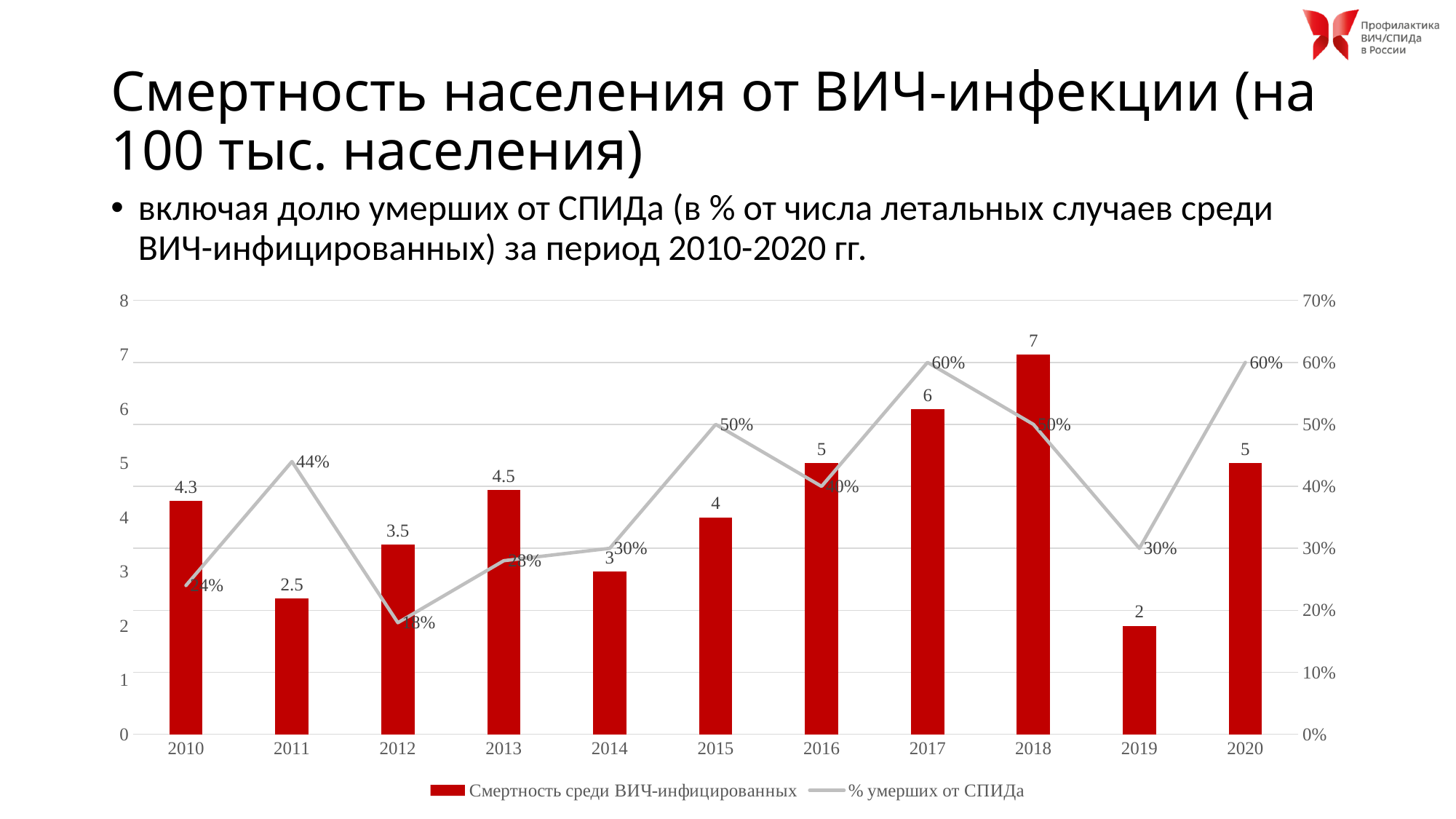
Which year has a larger bar value, 2016 or 2017? 2017 Which year has the highest bar for Смертность среди ВИЧ-инфицированных? 2018 What is the value of the bar for 2018 (Смертность среди ВИЧ-инфицированных)? 7 How many years are shown on the x axis of the chart? 11 Which year has the lowest bar for Смертность среди ВИЧ-инфицированных? 2019 What is the difference between the bar values for 2018 and 2019? 5 What is the value of the line (% умерших от СПИДа) for 2017? 60% Do the bar values rise or fall from 2016 to 2018? Rise What is the value of the bar for 2010? 4.3 How many series does the legend list? 2 What kind of chart is shown on the slide? Combined bar and line chart What is the value of the line (% умерших от СПИДа) for 2011? 44%